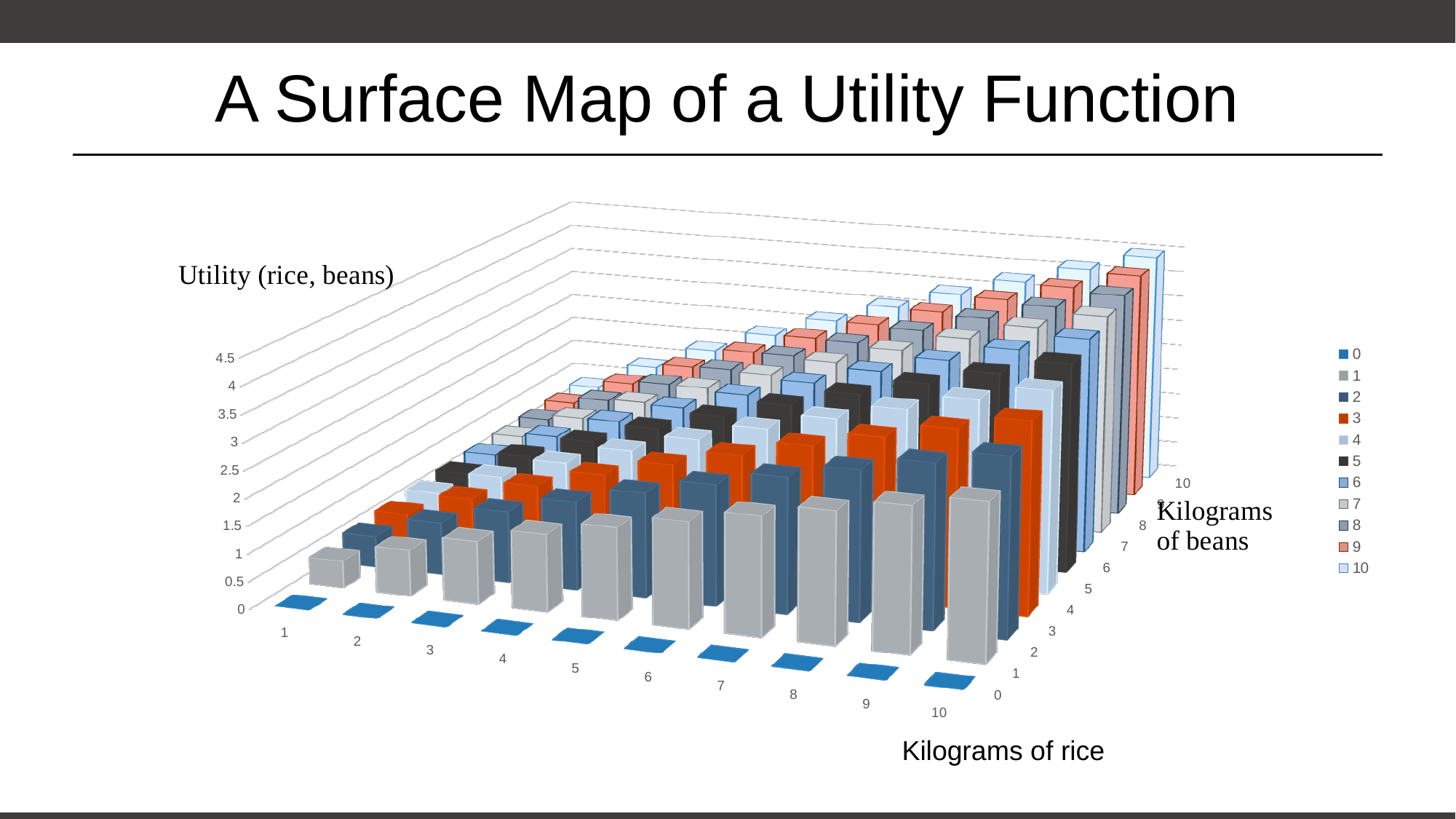
Within the series labelled 1, at which kilograms of rice value is the bar lowest? 1 How many categories are shown along the Kilograms of rice axis? 10 What is the label of the vertical axis? Utility (rice, beans) Within the series labelled 1, at which kilograms of rice value is the bar highest? 10 For the series labelled 10 (ten kilograms of beans), do the bars rise or fall as kilograms of rice increase? rise In the series labelled 1, which bar is larger: the one at 10 kilograms of rice or the one at 1 kilogram of rice? 10 kilograms of rice What is the highest tick value shown on the vertical axis? 4.5 Is the value for the series labelled 0 at 5 kilograms of rice greater or less than 0.5? less What is the title of the chart? A Surface Map of a Utility Function For the series labelled 1 (one kilogram of beans), do the bars rise or fall as kilograms of rice increase from 1 to 10? rise How many series does the legend list? 11 What kind of chart is shown on the slide? bar chart